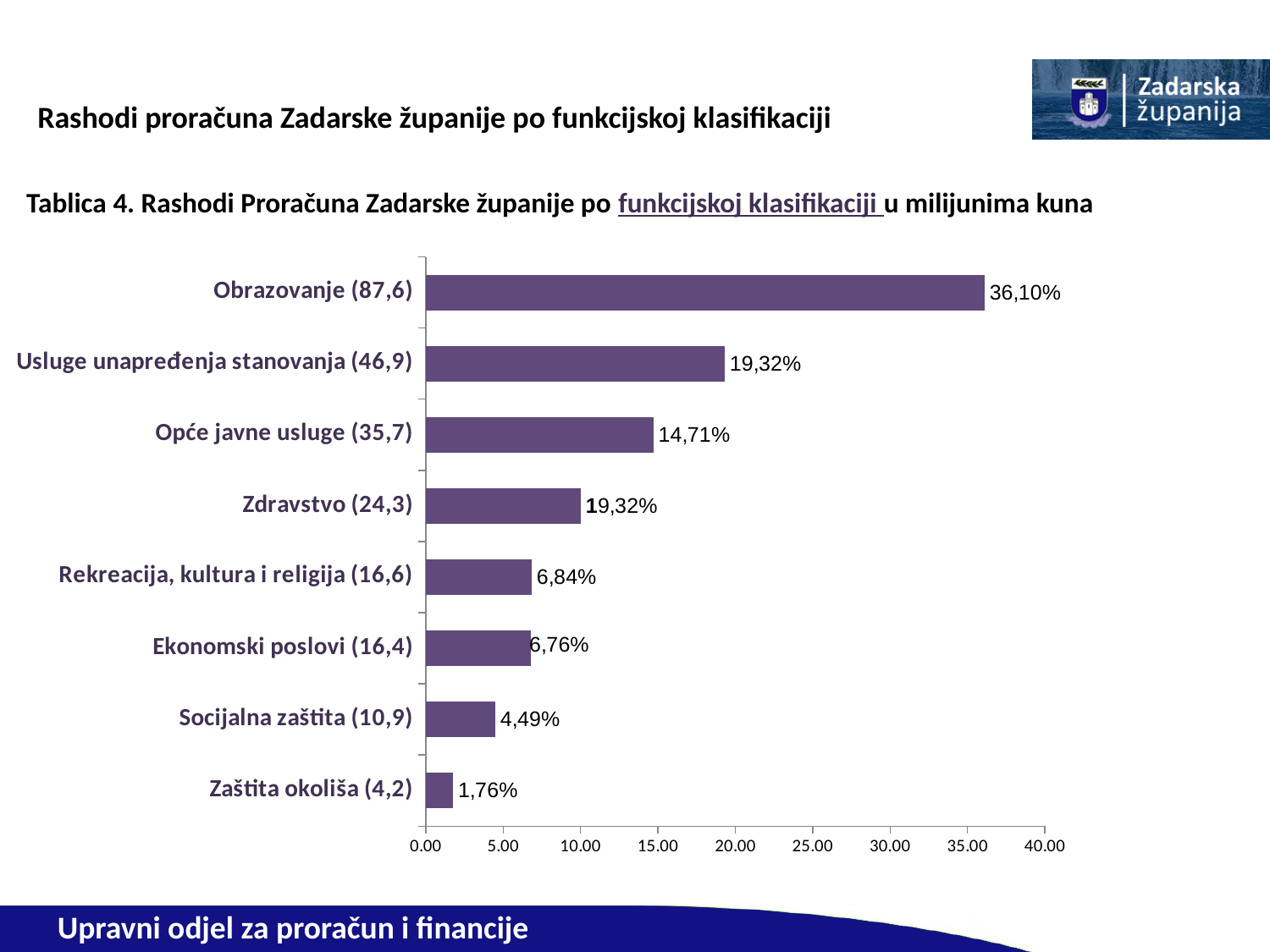
What percentage is shown for Obrazovanje (87,6)? 36,10% What percentage is shown for Zaštita okoliša (4,2)? 1,76% Which is larger, the value for Rekreacija, kultura i religija (16,6) or the value for Socijalna zaštita (10,9)? Rekreacija, kultura i religija (16,6) How many categories are plotted in the chart? 8 Which category has the highest value in the chart? Obrazovanje (87,6) What percentage is shown for Socijalna zaštita (10,9)? 4,49% What percentage is shown for Usluge unapređenja stanovanja (46,9)? 19,32% What percentage is shown for Opće javne usluge (35,7)? 14,71% Which category has the lowest value in the chart? Zaštita okoliša (4,2) What kind of chart is shown on the slide? bar chart What is the difference between the percentages for Obrazovanje (87,6) and Opće javne usluge (35,7)? 21,39% Is the value for Usluge unapređenja stanovanja (46,9) greater or less than 15.00? greater